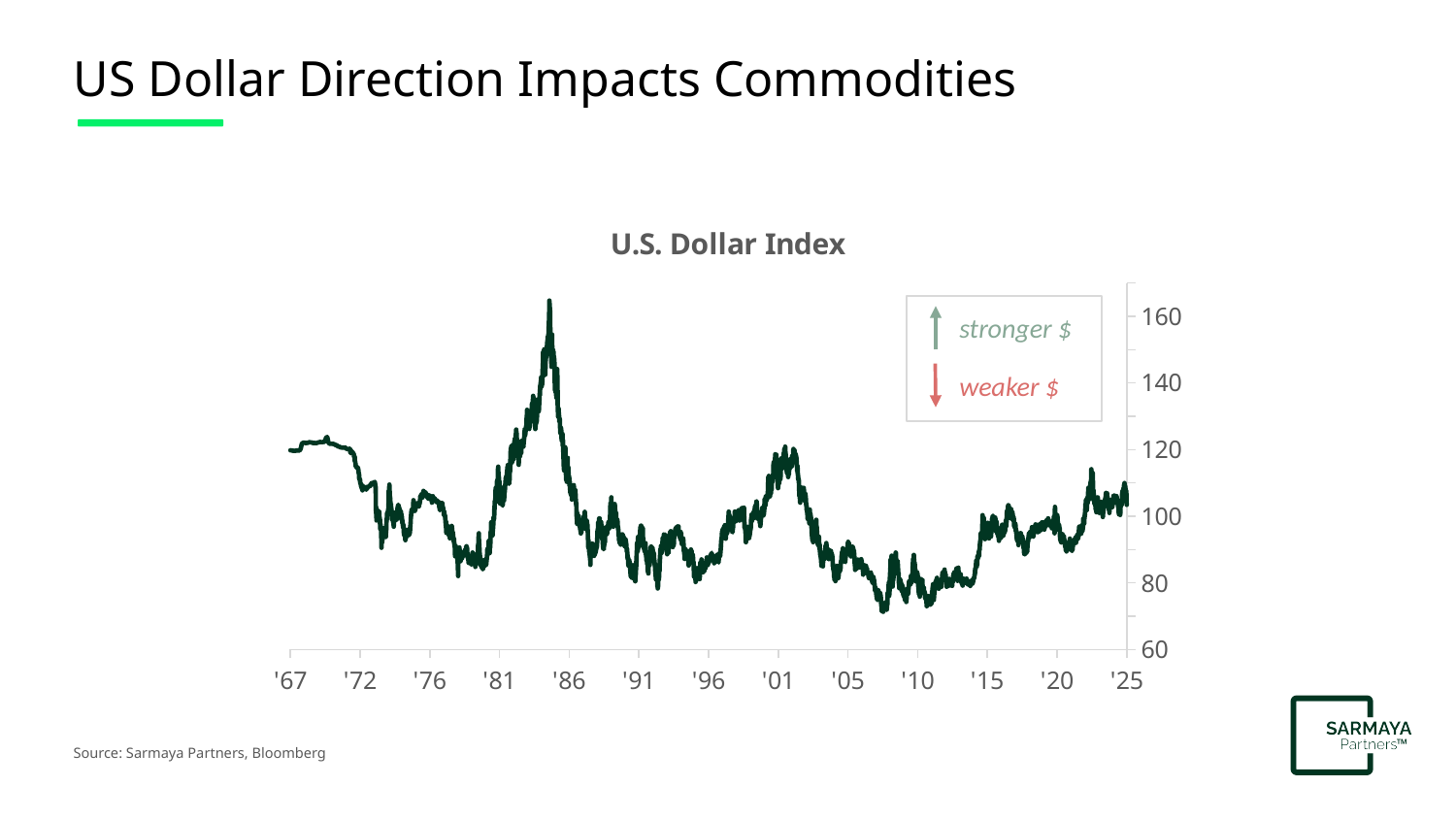
What is the title of the chart? U.S. Dollar Index Does the U.S. Dollar Index reach its highest point before or after '91? before Does the U.S. Dollar Index reach its lowest point before or after '01? after Is the value of the U.S. Dollar Index at '25 greater or less than 100? greater Does the U.S. Dollar Index rise or fall between '86 and '91? fall What kind of chart is shown on the slide? Line chart Does the U.S. Dollar Index rise or fall between '81 and '86? rise How many year labels are shown on the horizontal axis? 13 What is the highest value shown on the chart's vertical axis? 160 Is the peak value of the U.S. Dollar Index in the mid-1980s greater or less than 140? greater Is the value of the U.S. Dollar Index around '01 greater or less than 100? greater